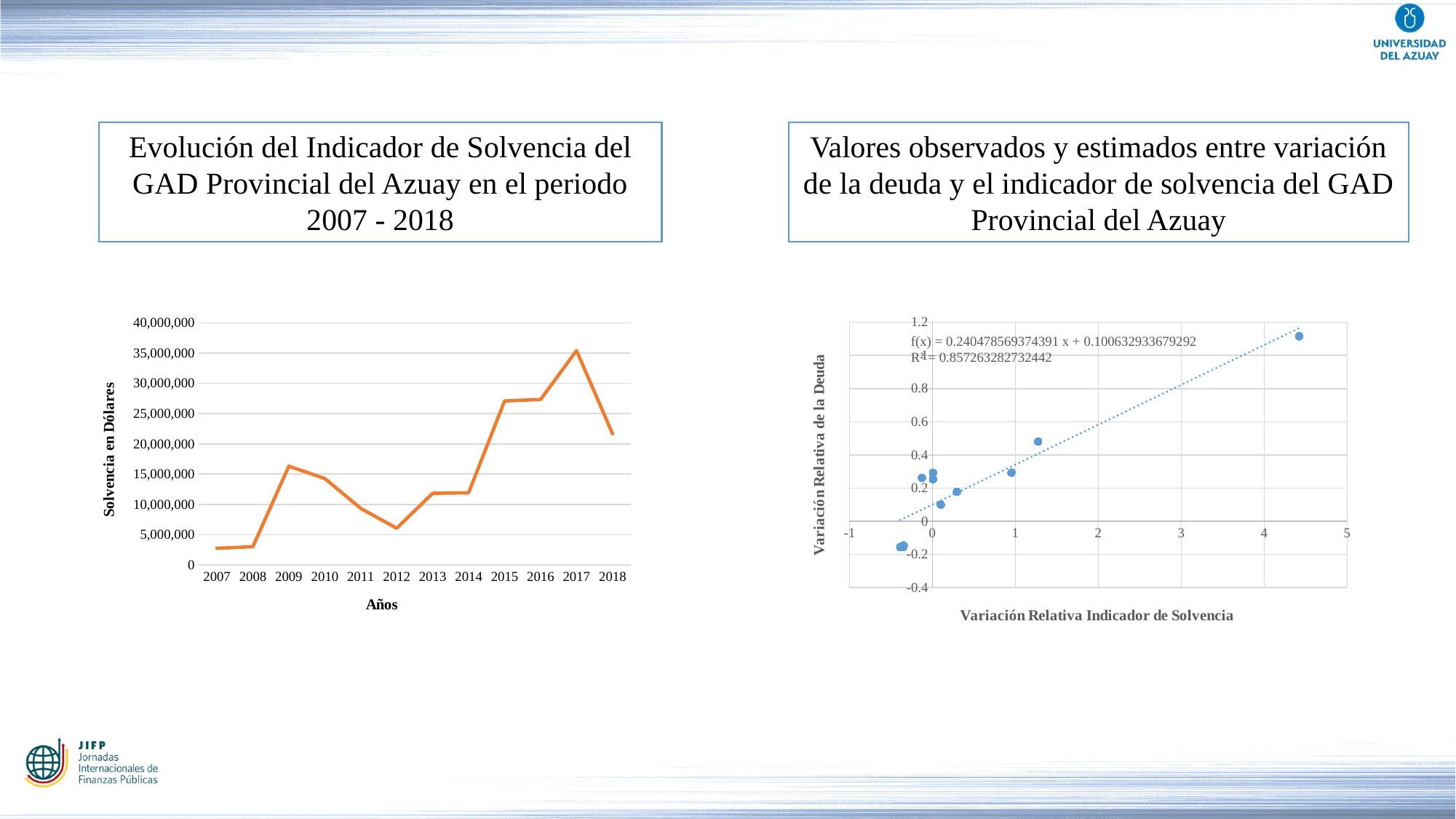
In the left chart, which year has the highest solvency value? 2017 In the left chart, is the value for 2018 greater or less than 25,000,000? less In the left chart, is the value for 2012 greater or less than 10,000,000? less In the left chart, is the value for 2009 greater or less than 15,000,000? greater What type of chart is the left chart, 'Evolución del Indicador de Solvencia del GAD Provincial del Azuay en el periodo 2007 - 2018'? Line chart In the right chart, what is the title of the y axis? Variación Relativa de la Deuda In the left chart, which year has the larger value, 2009 or 2010? 2009 In the left chart, does the solvency value rise or fall from 2017 to 2018? Fall In the right chart, what is the R² value shown for the trendline? 0.857263282732442 What type of chart is the right chart, 'Valores observados y estimados entre variación de la deuda y el indicador de solvencia del GAD Provincial del Azuay'? Scatter chart In the left chart, how many years are shown on the x axis? 12